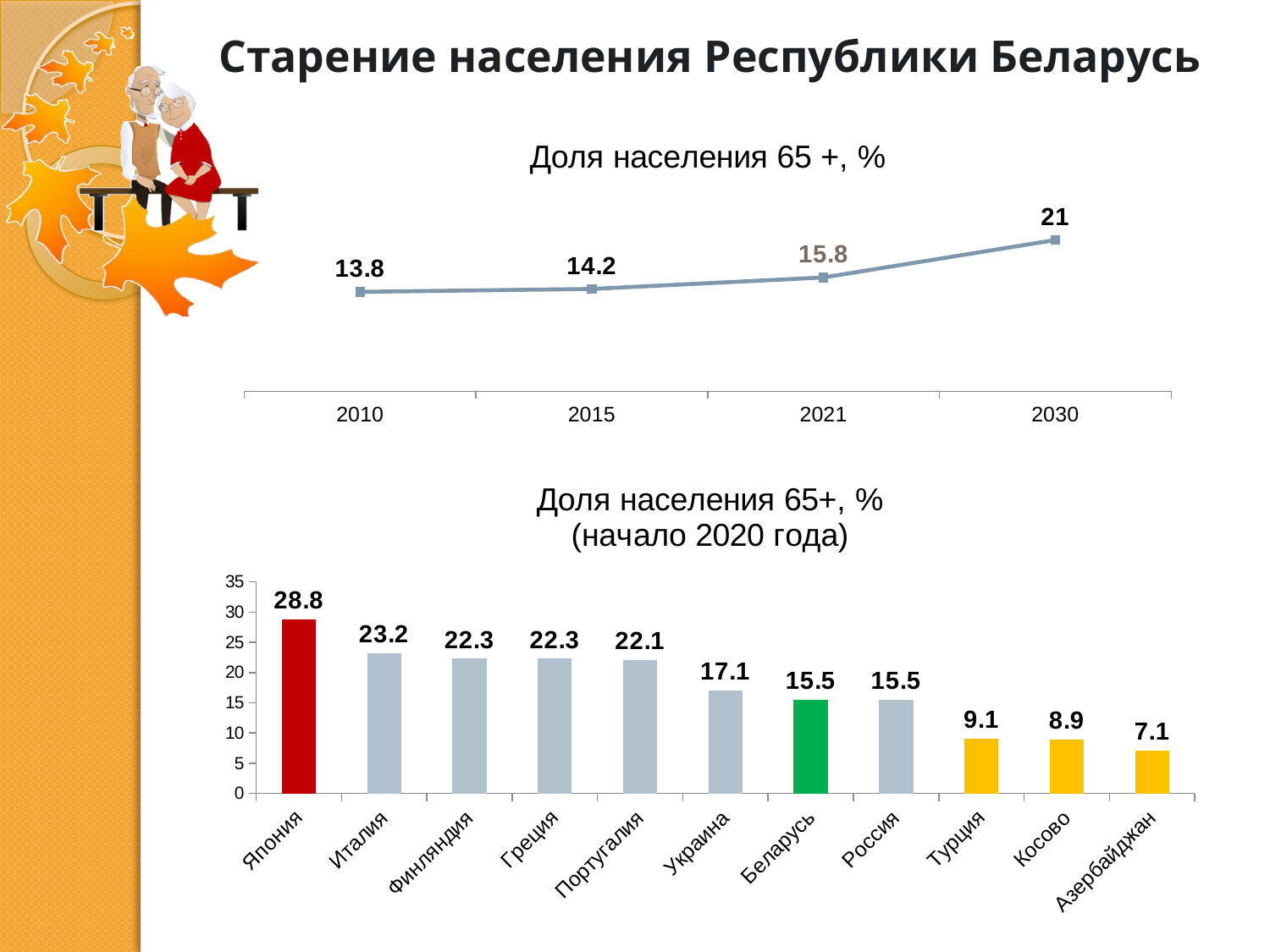
In the top chart 'Доля населения 65 +, %', what is the value for 2030? 21 What kind of chart is the top chart 'Доля населения 65 +, %'? line chart In the top chart 'Доля населения 65 +, %', how many data points are plotted? 4 In the bottom chart 'Доля населения 65+, % (начало 2020 года)', which country has the lowest value? Азербайджан In the top chart 'Доля населения 65 +, %', do the values rise or fall from 2010 to 2030? rise In the bottom chart 'Доля населения 65+, % (начало 2020 года)', what is the difference between Япония and Италия? 5.6 In the top chart 'Доля населения 65 +, %', what is the difference between the 2030 value and the 2010 value? 7.2 In the bottom chart 'Доля населения 65+, % (начало 2020 года)', which country has the highest value? Япония In the top chart 'Доля населения 65 +, %', what is the value for 2021? 15.8 In the bottom chart 'Доля населения 65+, % (начало 2020 года)', how many countries are shown? 11 In the bottom chart 'Доля населения 65+, % (начало 2020 года)', what is the value for Беларусь? 15.5 In the bottom chart 'Доля населения 65+, % (начало 2020 года)', what colour is the bar for Беларусь? green